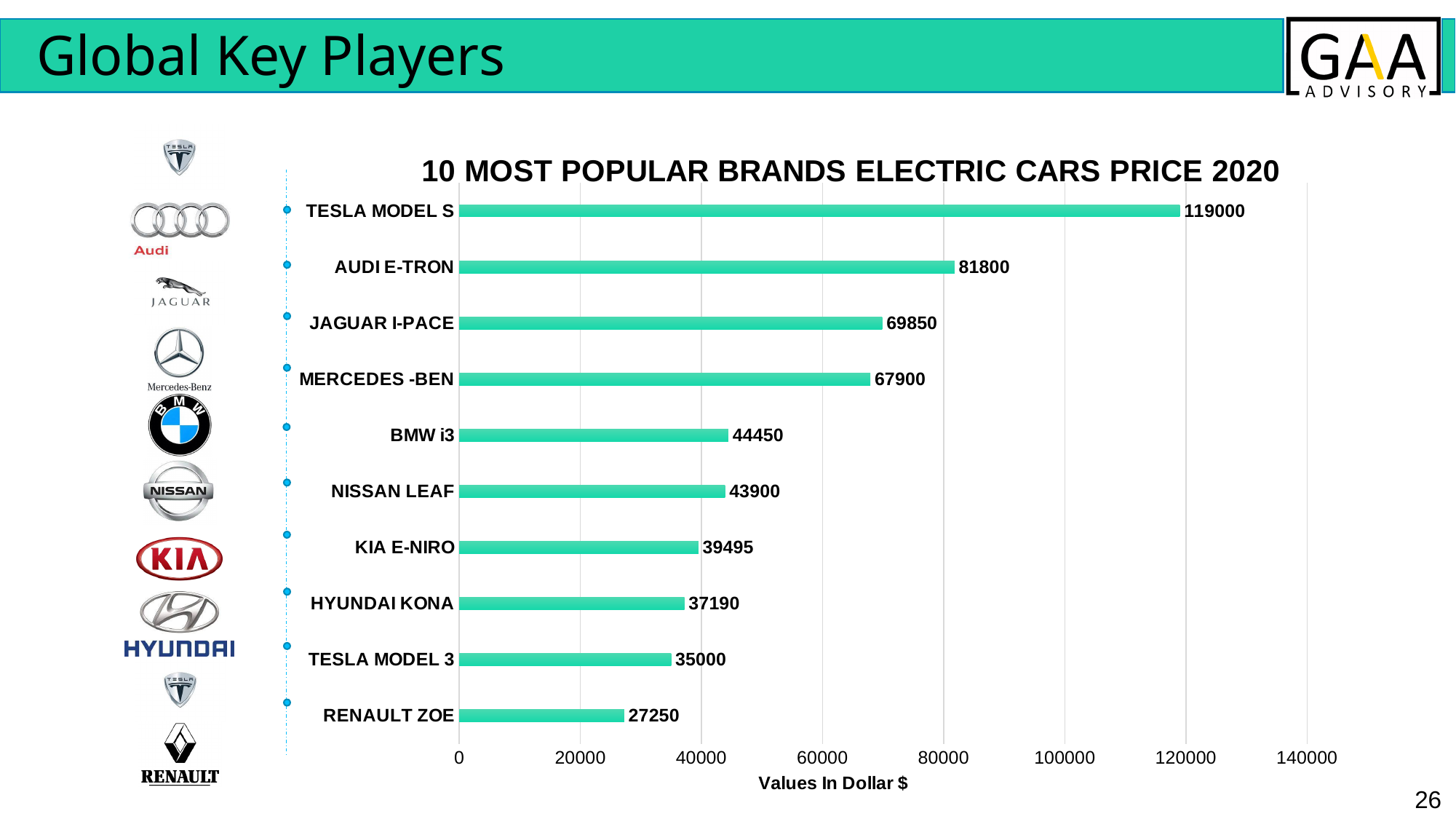
What is the price shown for the Nissan Leaf? 43900 Which car has the highest price on the chart? TESLA MODEL S What is the difference in price between the Tesla Model S and the Tesla Model 3? 84000 What is the title of the chart? 10 MOST POPULAR BRANDS ELECTRIC CARS PRICE 2020 What is the price shown for the Hyundai Kona? 37190 What is the price shown for the Tesla Model S? 119000 What type of chart is used on this slide? Bar chart Is the price of the Mercedes-Benz greater or less than 60000? greater What is the difference in price between the Audi E-Tron and the Jaguar I-Pace? 11950 Which car has the lowest price on the chart? RENAULT ZOE Which is priced higher, the BMW i3 or the Kia E-Niro? BMW i3 How many car models are shown on the chart? 10